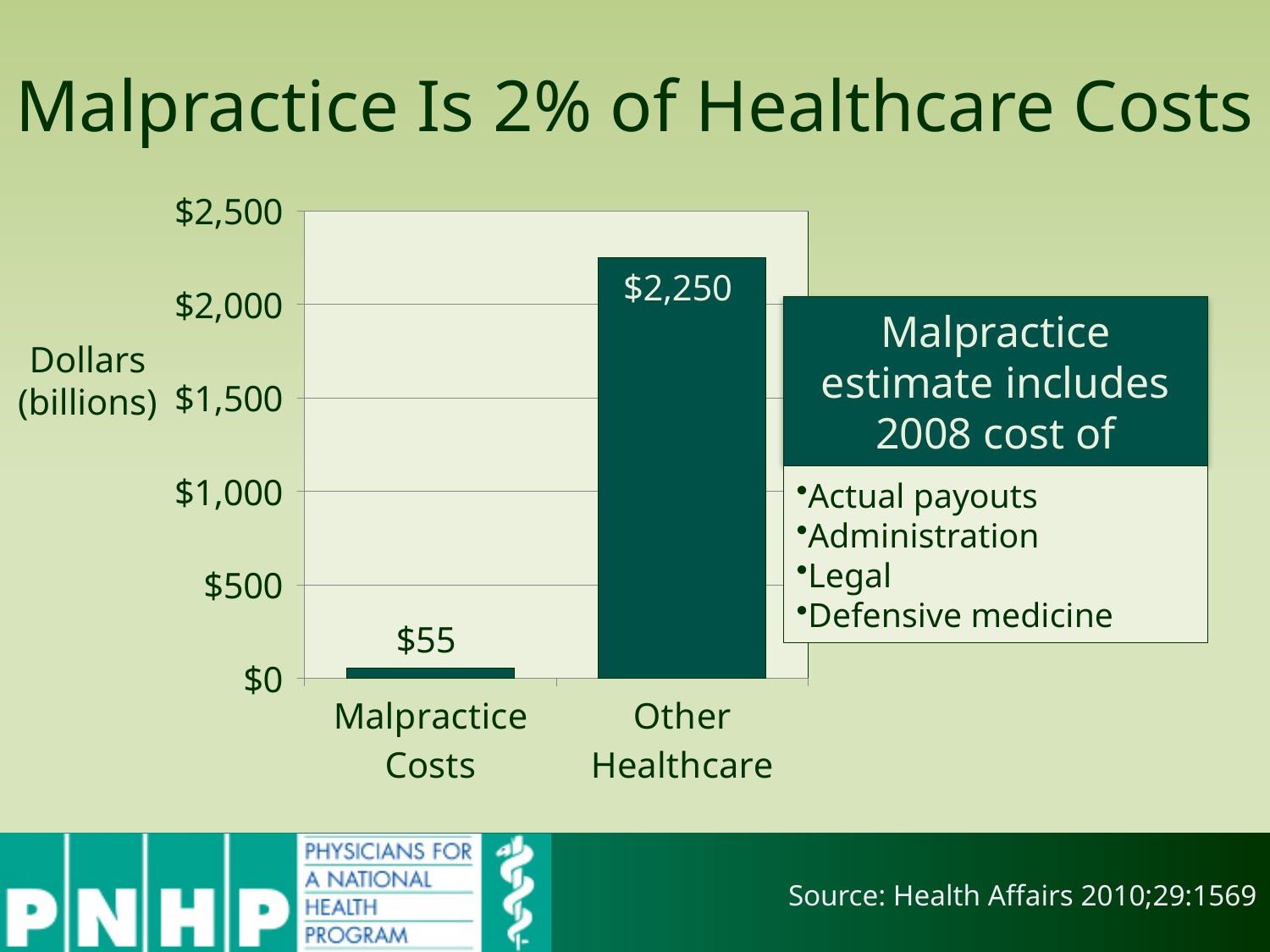
Which category has the lowest value? Malpractice Costs Which category has the highest value? Other Healthcare What is the value for Malpractice Costs? $55 What is the title of the slide? Malpractice Is 2% of Healthcare Costs Is the value for Other Healthcare greater or less than $2,000? greater Is the value for Malpractice Costs greater or less than $500? less How many categories are shown on the x axis? 2 What kind of chart is shown on the slide? bar chart What is the value for Other Healthcare? $2,250 What is the difference between the values for Other Healthcare and Malpractice Costs? $2,195 What is the label on the vertical axis? Dollars (billions) Which is larger, the value for Malpractice Costs or the value for Other Healthcare? Other Healthcare